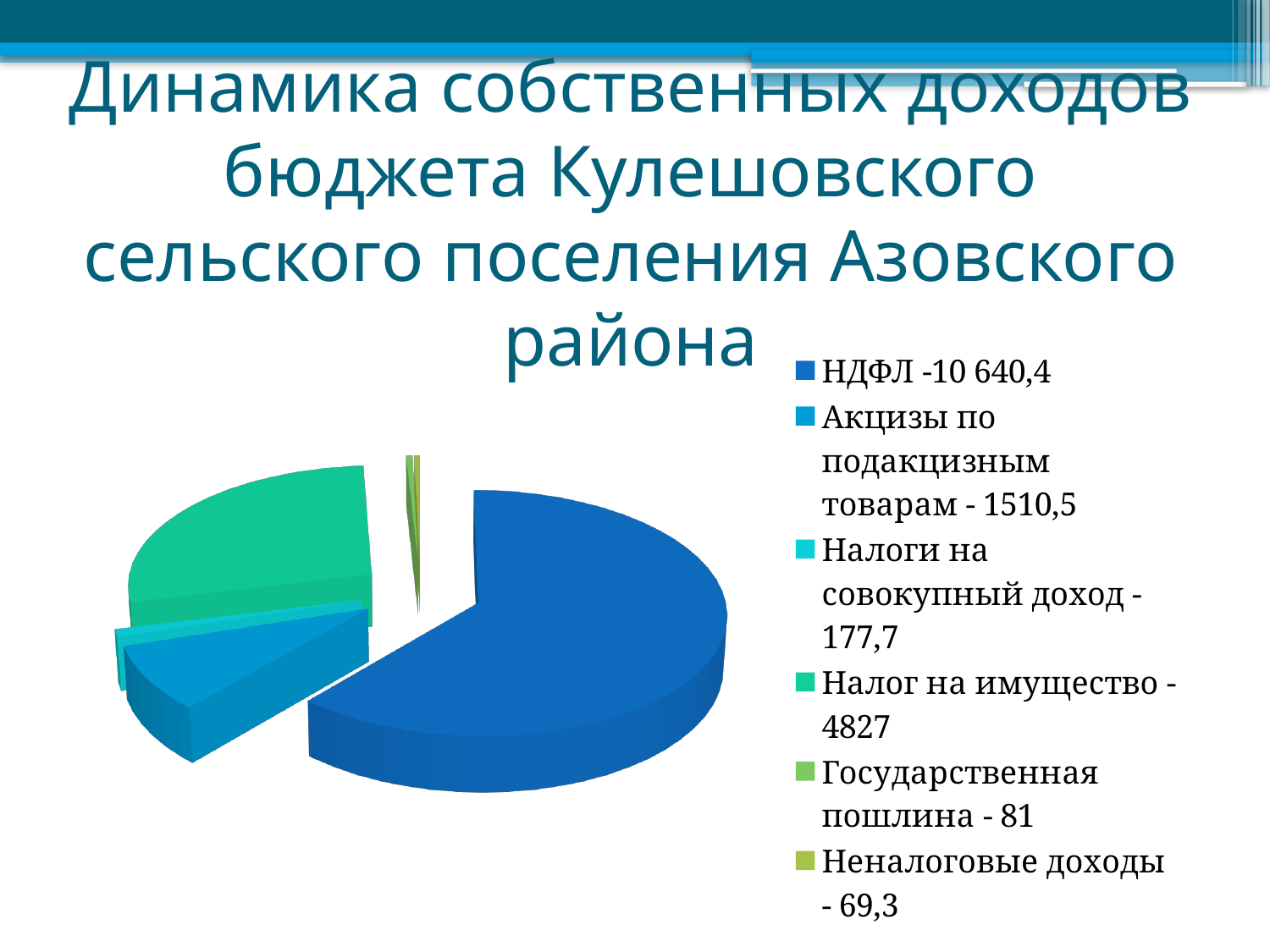
What is the value for НДФЛ? 10 640,4 What is the difference between the values for Налоги на совокупный доход and Государственная пошлина? 96,7 What is the value for Акцизы по подакцизным товарам? 1510,5 Which is larger: Налог на имущество or Акцизы по подакцизным товарам? Налог на имущество Which category has the smallest value? Неналоговые доходы How many categories does the pie chart's legend list? 6 What is the value for Государственная пошлина? 81 What is the title of the slide containing the chart? Динамика собственных доходов бюджета Кулешовского сельского поселения Азовского района What is the value for Налог на имущество? 4827 Which category has the largest value? НДФЛ What is the difference between the values for НДФЛ and Налог на имущество? 5813,4 What kind of chart is shown on the slide? Pie chart